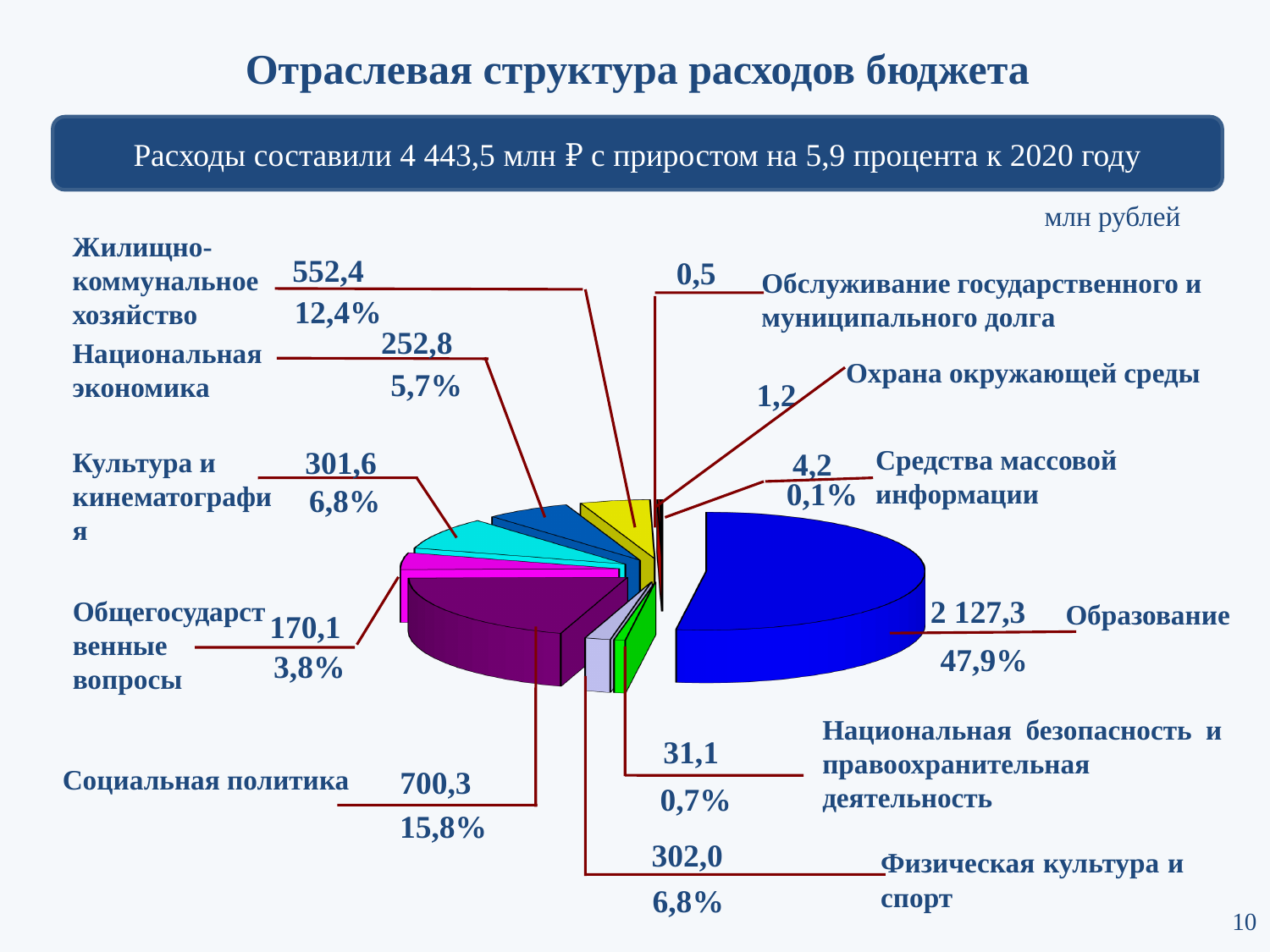
What is the expenditure value for Образование (млн рублей)? 2 127,3 Which is larger: the expenditure for Культура и кинематография or for Национальная экономика? Культура и кинематография What is the expenditure value for Социальная политика (млн рублей)? 700,3 What is the difference between the expenditure values for Социальная политика and Жилищно-коммунальное хозяйство (млн рублей)? 147,9 What is the title of the slide? Отраслевая структура расходов бюджета Which category has the largest share of budget expenditures? Образование What percentage share does Национальная безопасность и правоохранительная деятельность have? 0,7% What is the expenditure value for Охрана окружающей среды (млн рублей)? 1,2 Which category has the smallest expenditure value? Обслуживание государственного и муниципального долга How many categories are shown in the pie chart? 11 What kind of chart is shown on the slide? pie chart What share of expenditures does Жилищно-коммунальное хозяйство account for? 12,4%